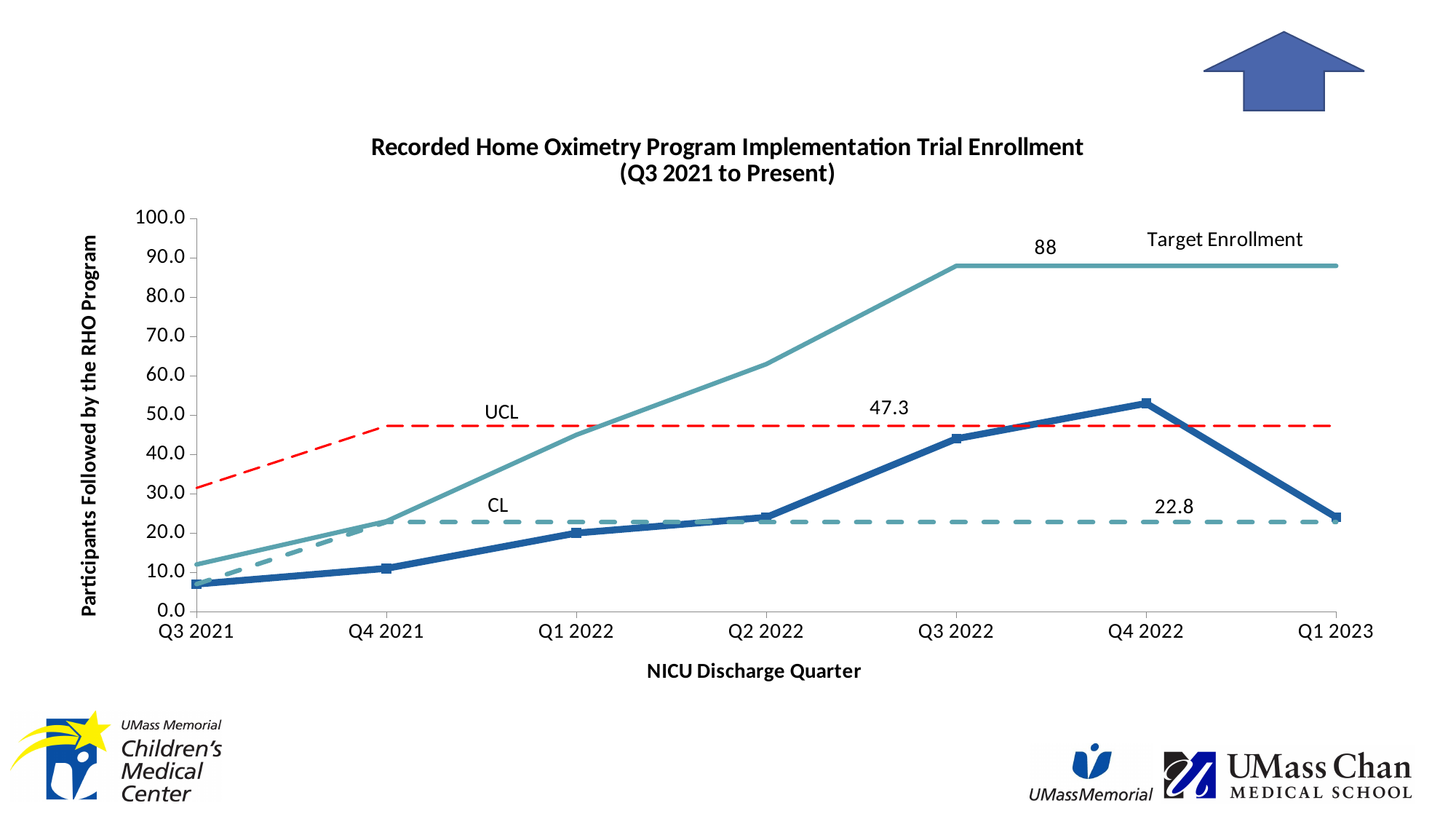
Is the value of the dark blue enrollment line for Q3 2021 greater or less than 10? less In which quarter is the dark blue enrollment line at its lowest value? Q3 2021 How many NICU discharge quarters are shown on the x axis? 7 In which quarter does the dark blue enrollment line reach its highest value? Q4 2022 What value is labeled on the Target Enrollment line? 88 What is the title of the x axis? NICU Discharge Quarter What value is labeled on the UCL line? 47.3 On the dark blue enrollment line, which is larger: the value for Q4 2022 or the value for Q1 2023? Q4 2022 Is the value of the dark blue enrollment line for Q4 2022 greater or less than 40? greater What kind of chart is shown on the slide? line chart What is the difference between the UCL value and the CL value? 24.5 What value is labeled on the CL line? 22.8